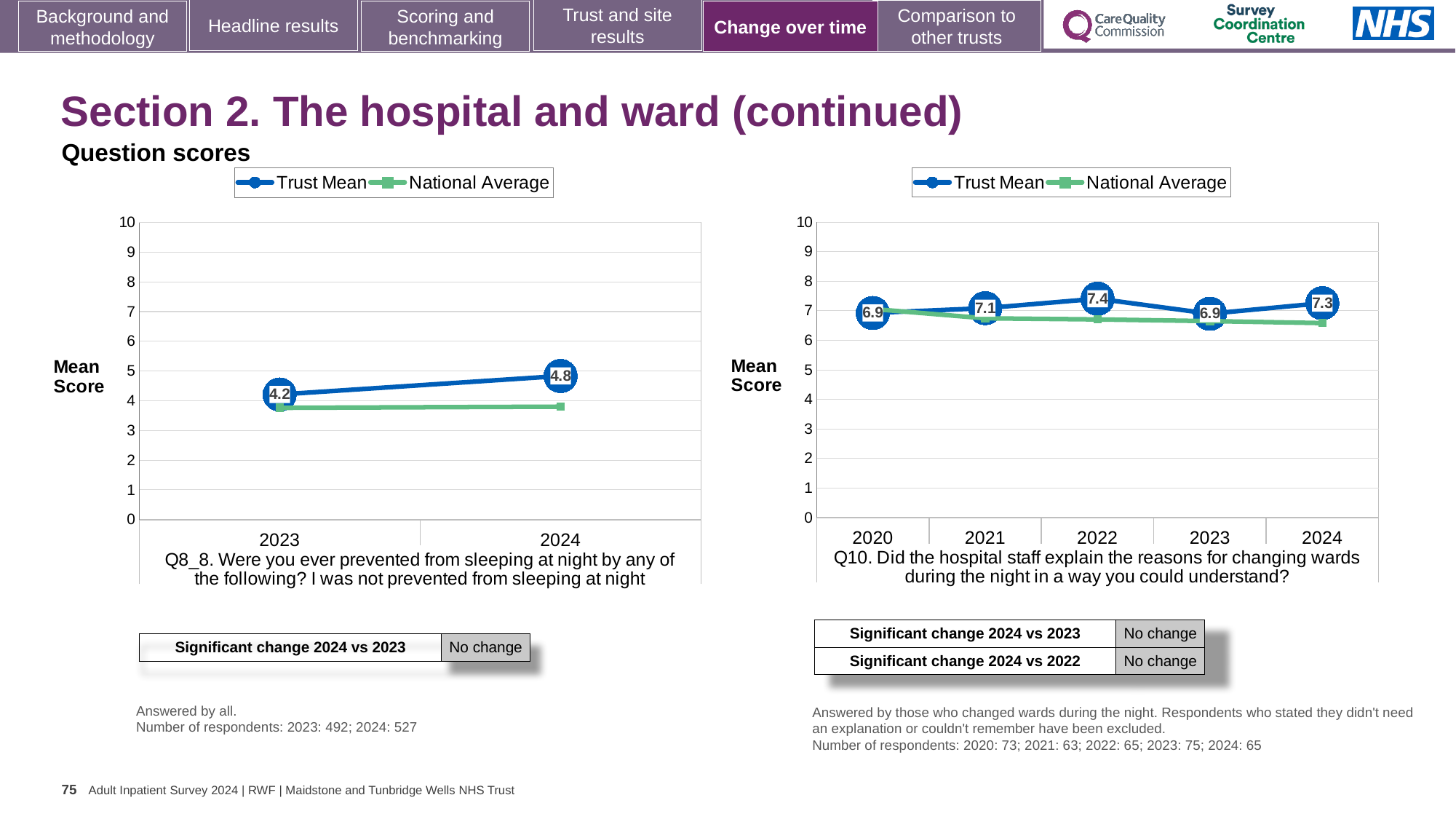
In the left chart (Q8_8), what is the Trust Mean score for 2024? 4.8 In the right chart (Q10), how many years are plotted on the x axis? 5 What type of chart is the left chart (Q8_8)? line chart In the left chart (Q8_8), does the Trust Mean rise or fall from 2023 to 2024? rise In the left chart (Q8_8), by how much did the Trust Mean change from 2023 to 2024? 0.6 In the left chart (Q8_8), is the National Average for 2024 greater or less than 4? less In the right chart (Q10), which year has the highest Trust Mean score? 2022 How many series does the legend of the right chart (Q10) list? 2 In the left chart (Q8_8), what is the Trust Mean score for 2023? 4.2 In the right chart (Q10), what is the Trust Mean score for 2022? 7.4 In the right chart (Q10), which is larger, the Trust Mean for 2021 or for 2024? 2024 In the right chart (Q10), what is the difference between the Trust Mean in 2022 and in 2023? 0.5